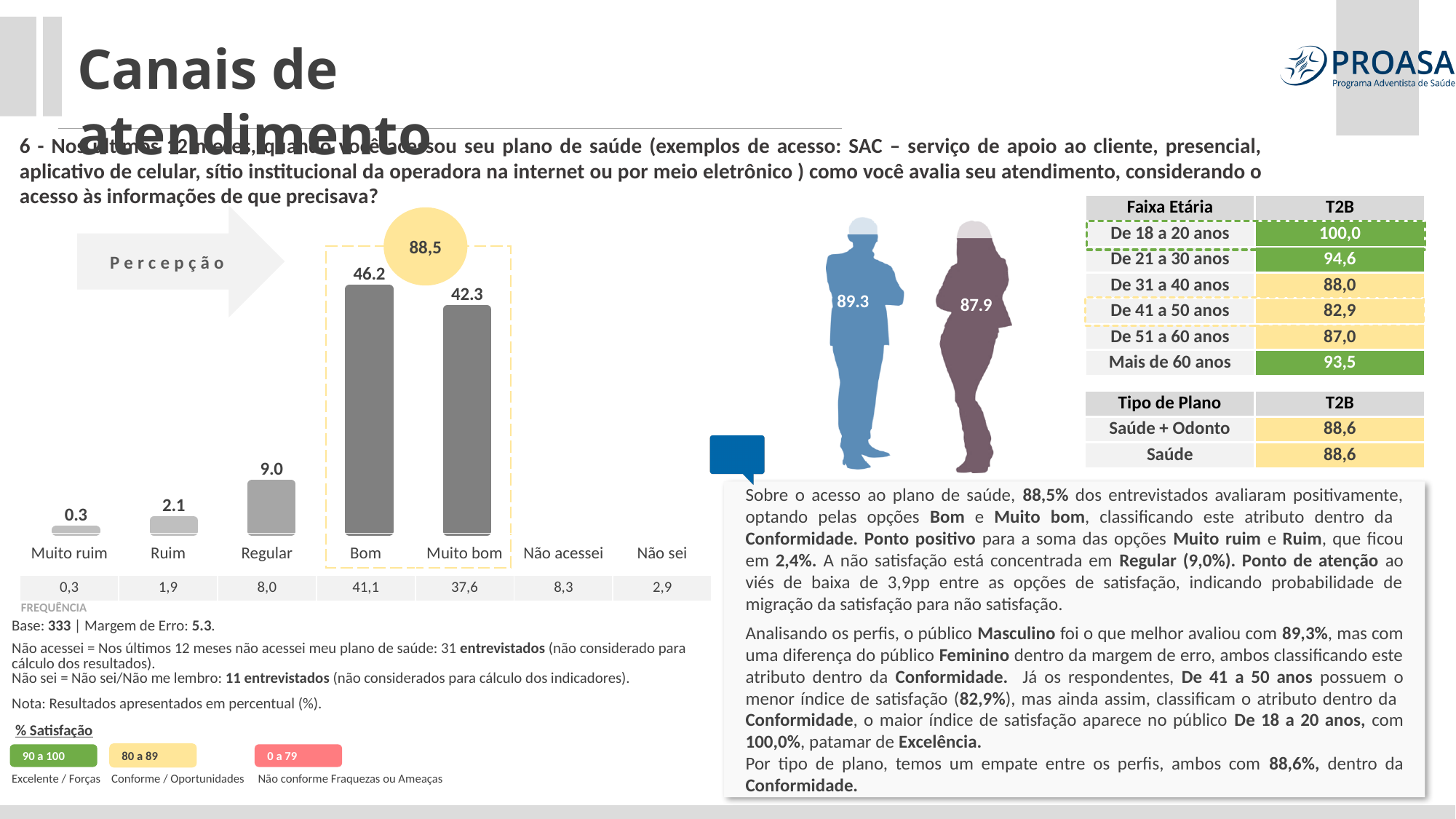
How many bars are plotted in the chart? 5 Which category has the lowest bar in the chart? Muito ruim What is the value for Muito ruim in the bar chart? 0.3 What is the difference between the values for Bom and Muito bom? 3.9 Which category has the highest bar in the chart? Bom Which is larger, the value for Regular or the value for Ruim? Regular What is the value for Regular in the bar chart? 9.0 What is the value for Ruim in the bar chart? 2.1 What kind of chart is shown on the slide? Bar chart What is the value for Muito bom in the bar chart? 42.3 What is the combined value of Bom and Muito bom shown in the highlighted circle above the bars? 88,5 What is the value for Bom in the bar chart? 46.2